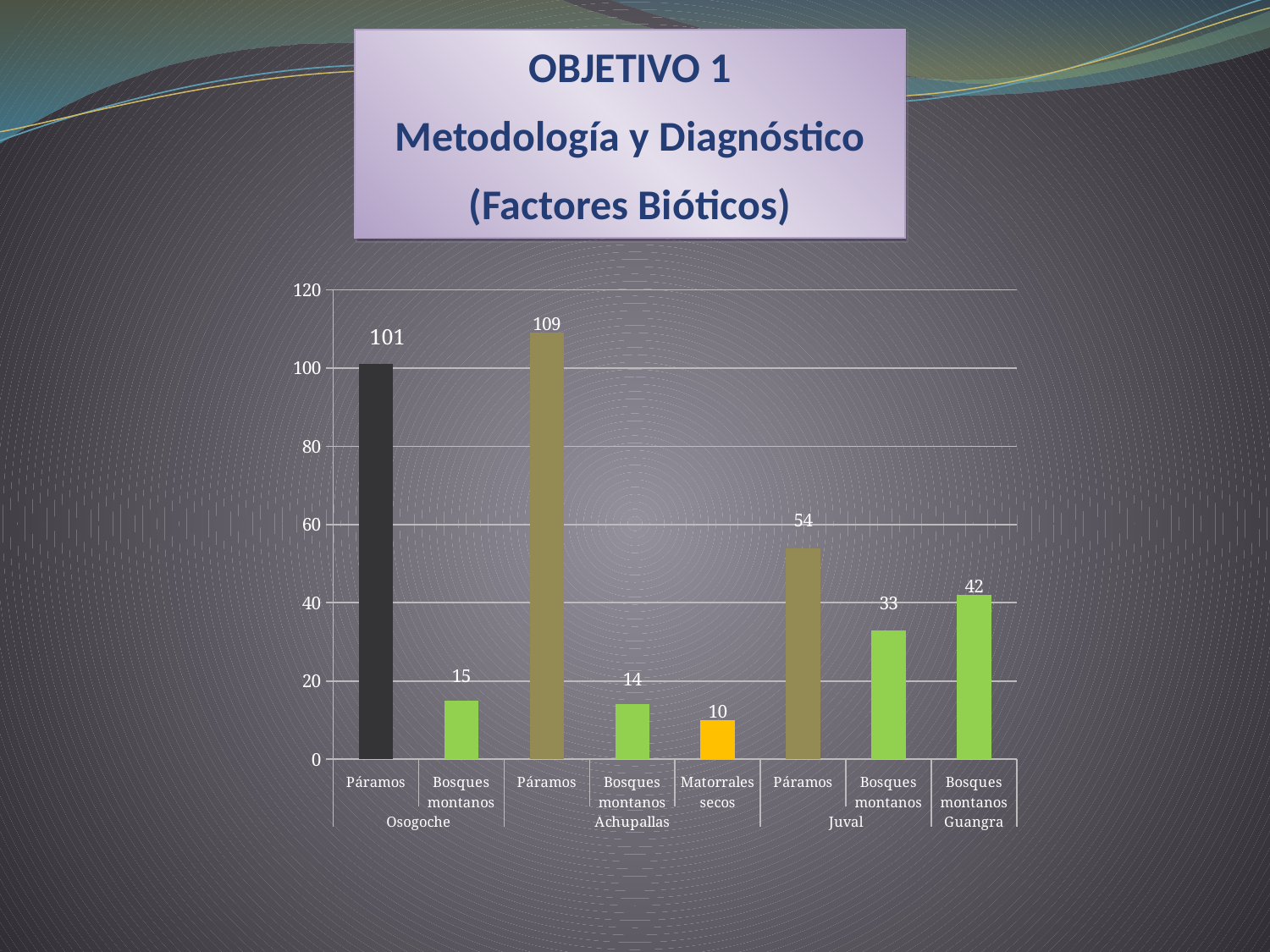
What is the value for Matorrales secos in Achupallas? 10 What is the value for Páramos in Osogoche? 101 What is the value for Bosques montanos in Juval? 33 Which bar has the highest value? Páramos in Achupallas What is the value for Bosques montanos in Guangra? 42 What is the difference between Páramos in Juval and Bosques montanos in Juval? 21 Which is larger: Bosques montanos in Guangra or Bosques montanos in Juval? Bosques montanos in Guangra Is the value for Páramos in Juval greater or less than 60? less What is the difference between Páramos in Achupallas and Páramos in Osogoche? 8 Which bar has the lowest value? Matorrales secos in Achupallas What kind of chart is shown on the slide? Bar chart How many bars are plotted in the chart? 8